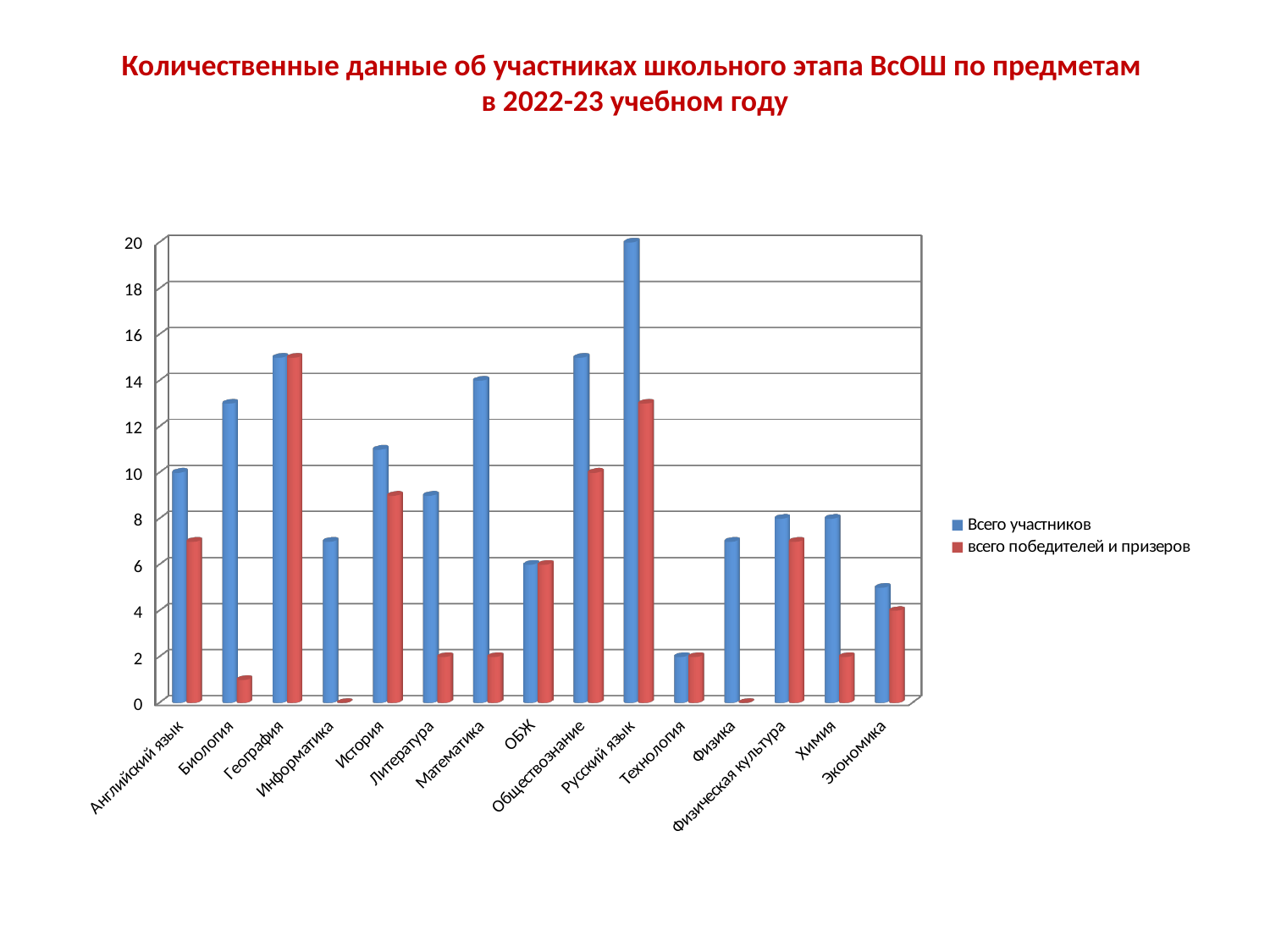
Which subject has the lowest value for 'Всего участников'? Технология Which subject has the highest value for 'всего победителей и призеров'? География What is the value of 'всего победителей и призеров' for Обществознание? 10 Is the value of 'Всего участников' for Биология greater or less than 12? greater How many series does the legend list? 2 What kind of chart is shown on the slide? bar chart Which is larger: 'Всего участников' for Русский язык or for Обществознание? Русский язык How many subjects (categories) are shown on the x axis? 15 Which subject has the highest value for 'Всего участников'? Русский язык What is the value of 'Всего участников' for Английский язык? 10 Is the value of 'всего победителей и призеров' for Физика greater or less than 2? less What is the value of 'Всего участников' for Русский язык? 20